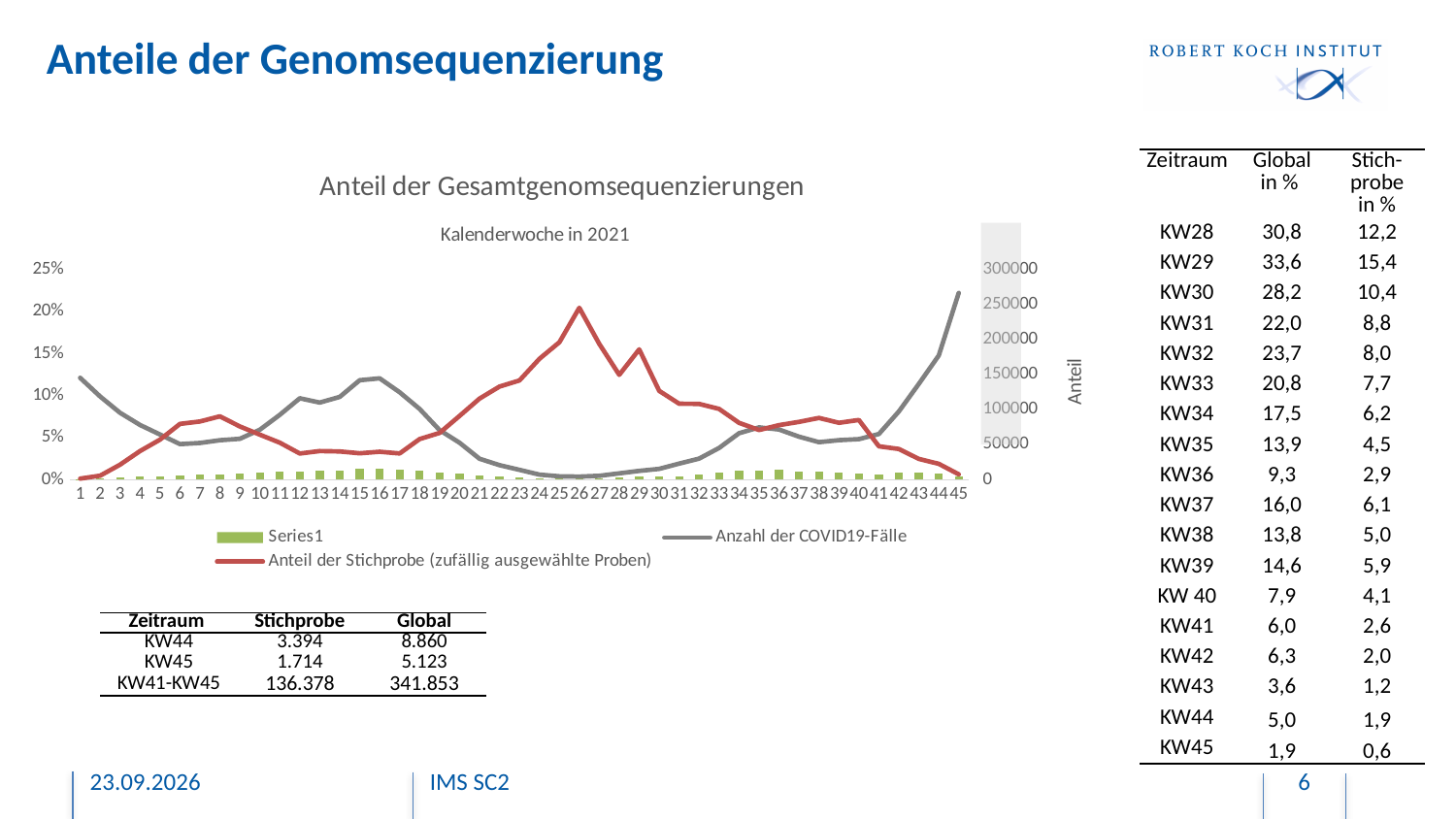
How many calendar weeks are plotted along the x axis? 45 How many series does the chart legend list? 3 Does the Anzahl der COVID19-Fälle line rise or fall from week 40 to week 45? rise At which calendar week does the Anteil der Stichprobe line reach its highest value? 26 What kind of chart is used to plot Series1? bar chart What kind of chart is used to plot Anzahl der COVID19-Fälle? line chart Is the value of Anzahl der COVID19-Fälle at week 26 greater or less than 50000? less Which is larger for Anzahl der COVID19-Fälle: the value at week 16 or the value at week 45? week 45 What is the title of the chart? Anteil der Gesamtgenomsequenzierungen Is the value of Anzahl der COVID19-Fälle at week 45 greater or less than 200000? greater Is the value of Anteil der Stichprobe at week 26 greater or less than 15%? greater At which calendar week does the Anzahl der COVID19-Fälle line reach its highest value? 45